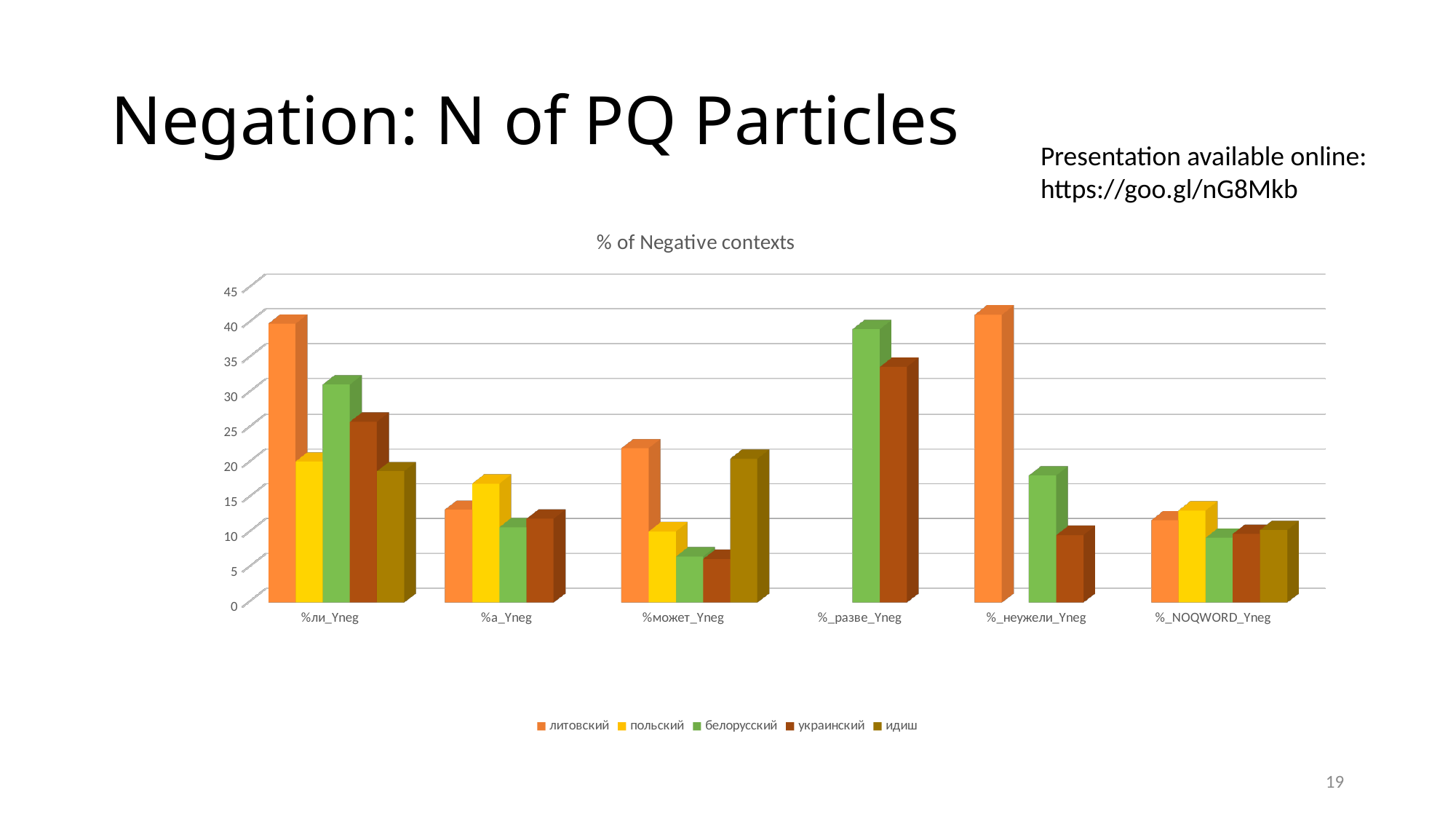
For %ли_Yneg, which is larger: белорусский or польский? белорусский How many series does the legend list? 5 Which series has the highest value for %_неужели_Yneg? литовский What is the title of the chart? % of Negative contexts Is the value for белорусский in %_разве_Yneg greater or less than 35? greater Which series has the highest value for %ли_Yneg? литовский What type of chart is shown on the slide? bar chart How many categories are shown on the x axis? 6 Is the value for литовский in %ли_Yneg greater or less than 35? greater Is the value for белорусский in %может_Yneg greater or less than 10? less Which series has the highest value for %а_Yneg? польский For %_неужели_Yneg, which is larger: белорусский or украинский? белорусский